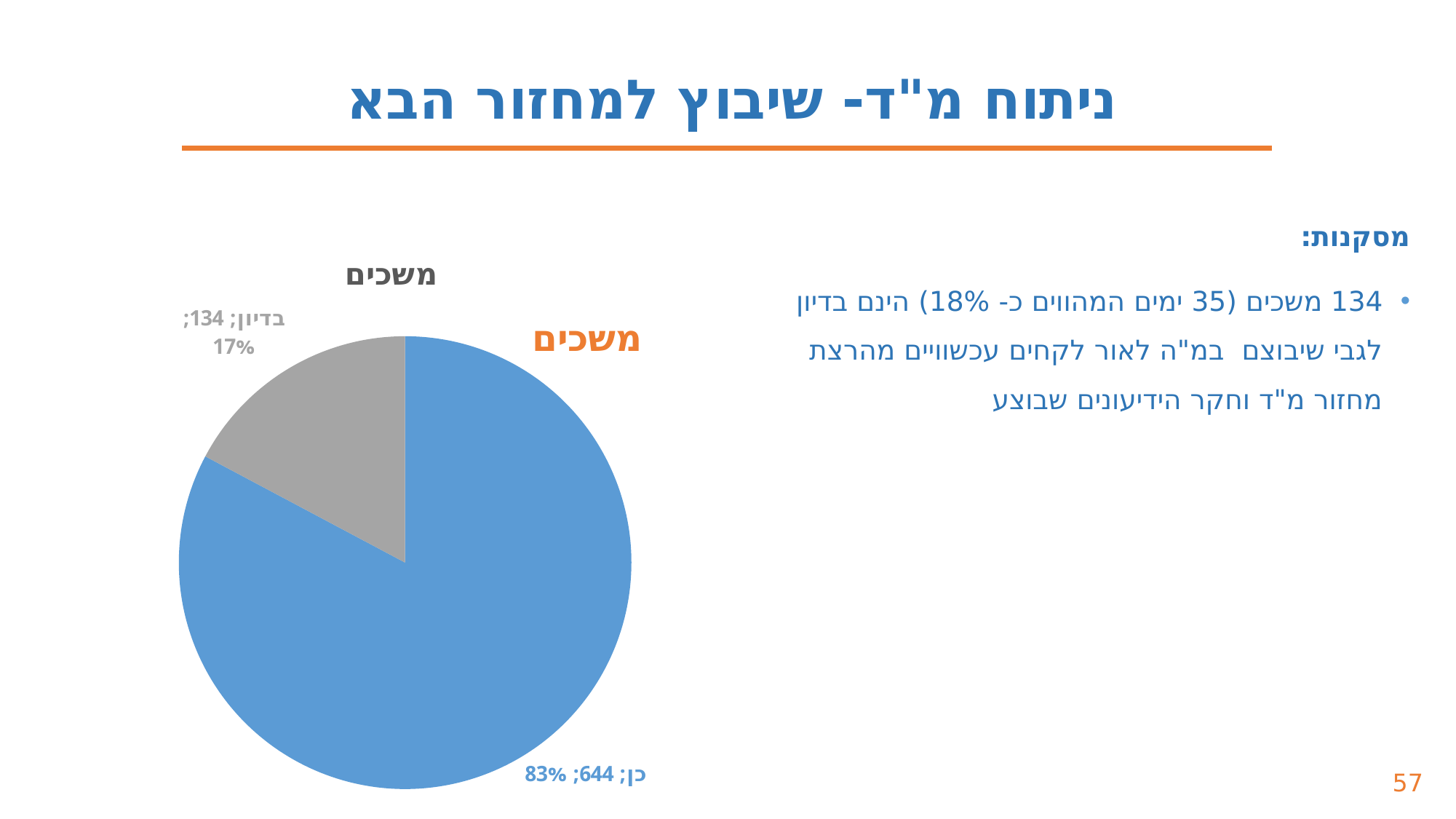
What is the value for the slice labelled "בדיון"? 134 What is the title of the pie chart? משכים What is the value for the slice labelled "כן"? 644 What is the difference between the values for "כן" and "בדיון"? 510 What share of the pie does the "בדיון" slice represent? 17% How many slices does the pie chart have? 2 What kind of chart is shown on the slide? pie chart What share of the pie does the "כן" slice represent? 83% What colour is the "בדיון" slice in the pie chart? gray Which is larger, the value for "כן" or the value for "בדיון"? כן Which slice is the smallest in the pie chart? בדיון Which slice is the largest in the pie chart? כן